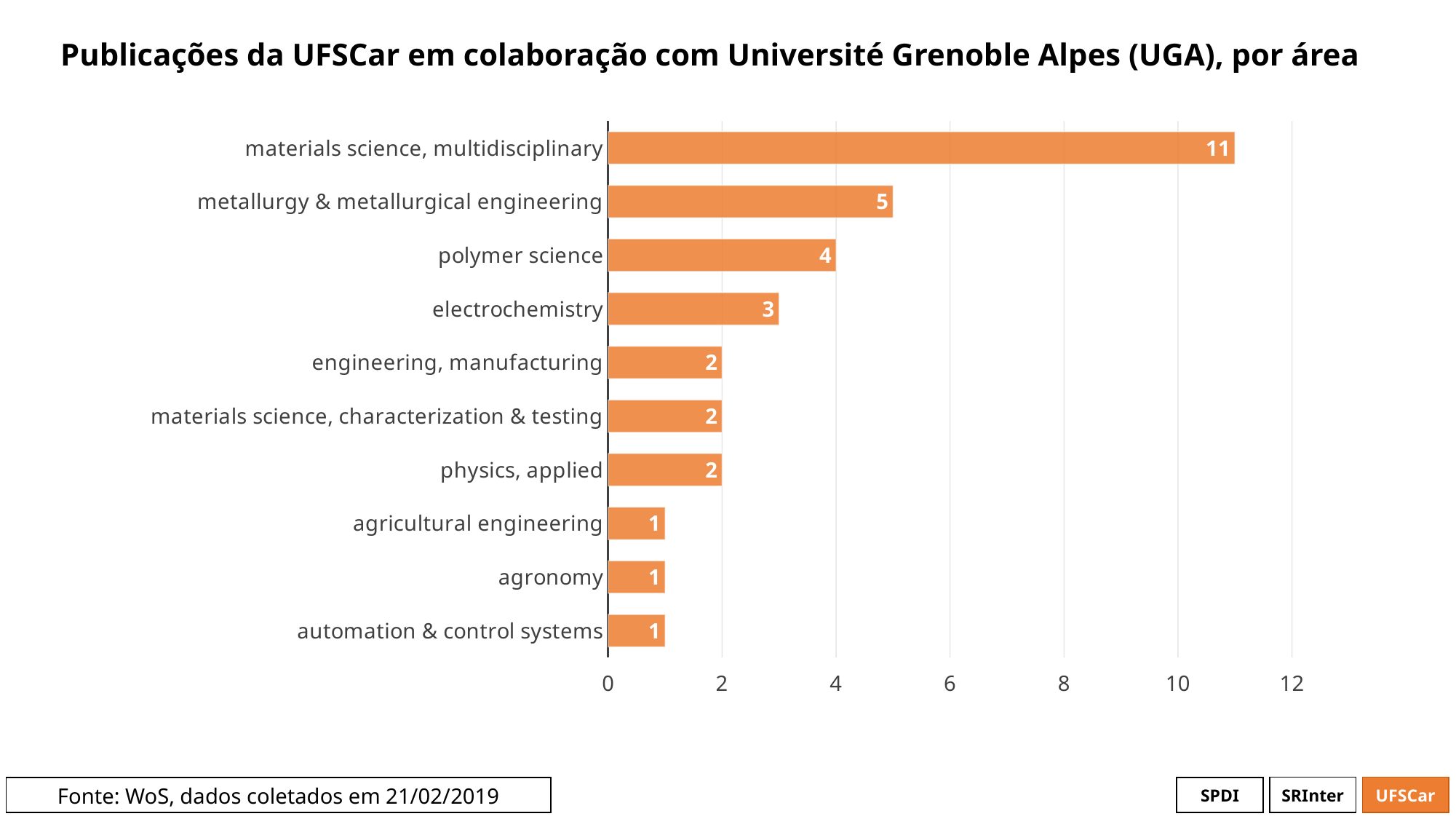
What is the value for physics, applied? 2 What is the value for materials science, multidisciplinary? 11 Which area has the highest number of publications? materials science, multidisciplinary How many areas are shown in the chart? 10 What is the difference between the values for materials science, multidisciplinary and metallurgy & metallurgical engineering? 6 What is the value for metallurgy & metallurgical engineering? 5 What is the value for electrochemistry? 3 What is the title of the chart? Publicações da UFSCar em colaboração com Université Grenoble Alpes (UGA), por área Is the value for materials science, multidisciplinary greater or less than 10? greater What kind of chart is shown on the slide? bar chart Which is larger, the value for polymer science or the value for electrochemistry? polymer science What is the value for polymer science? 4